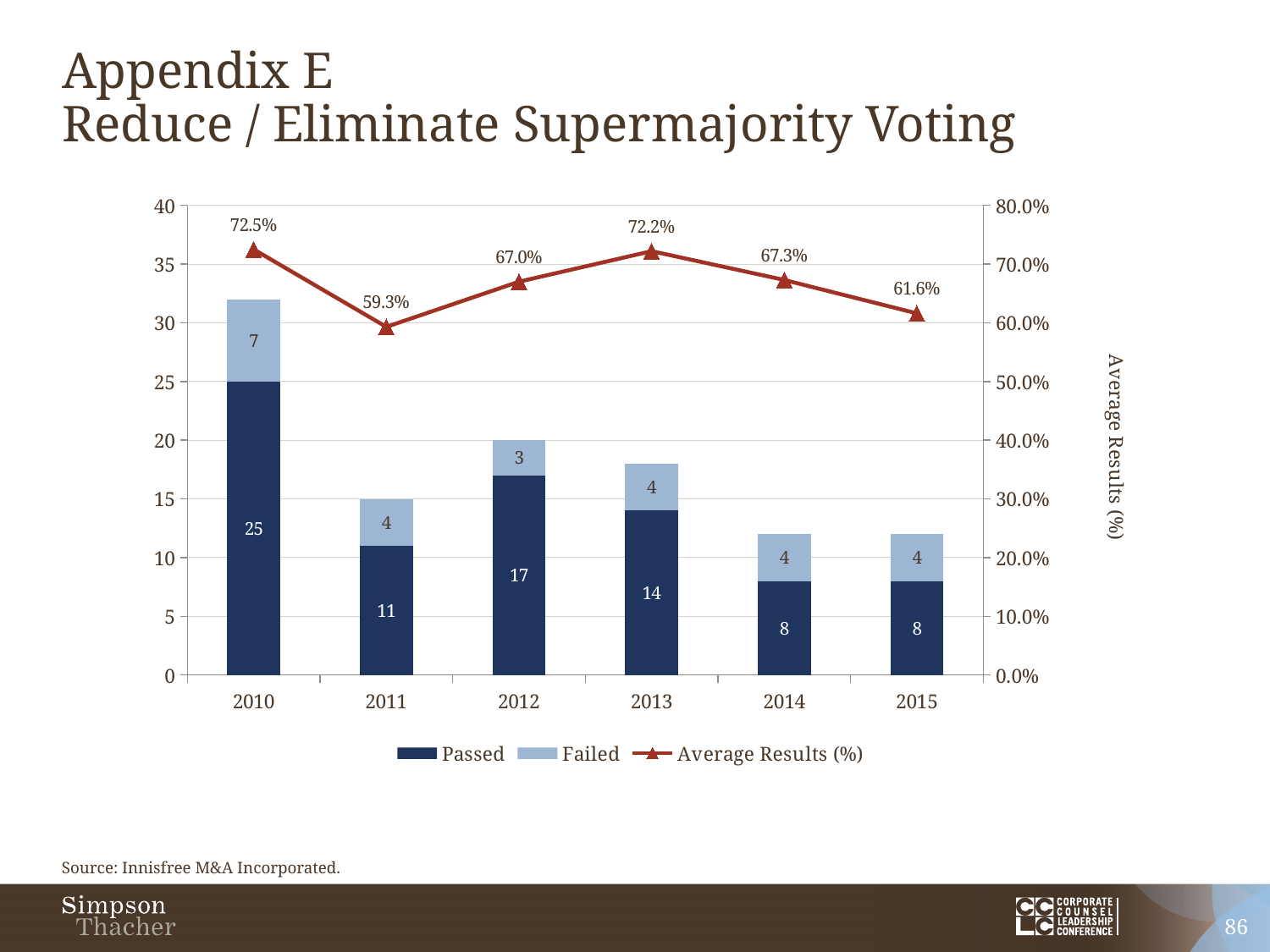
Which year has the lowest number of Passed proposals? 2014 and 2015 What kind of chart is shown on the slide? Stacked bar chart with a line How many proposals Failed in 2012? 3 Which is larger, the number of Passed proposals in 2012 or in 2013? 2012 What is the Average Results (%) value for 2011? 59.3% How many series does the legend list? 3 How many years are shown on the x axis? 6 What is the label of the right-hand vertical axis? Average Results (%) Which year has the highest Average Results (%)? 2010 What is the difference between the number of Passed proposals in 2010 and 2011? 14 What is the total of the stacked bar for 2013 (Passed plus Failed)? 18 How many proposals were Passed in 2010? 25